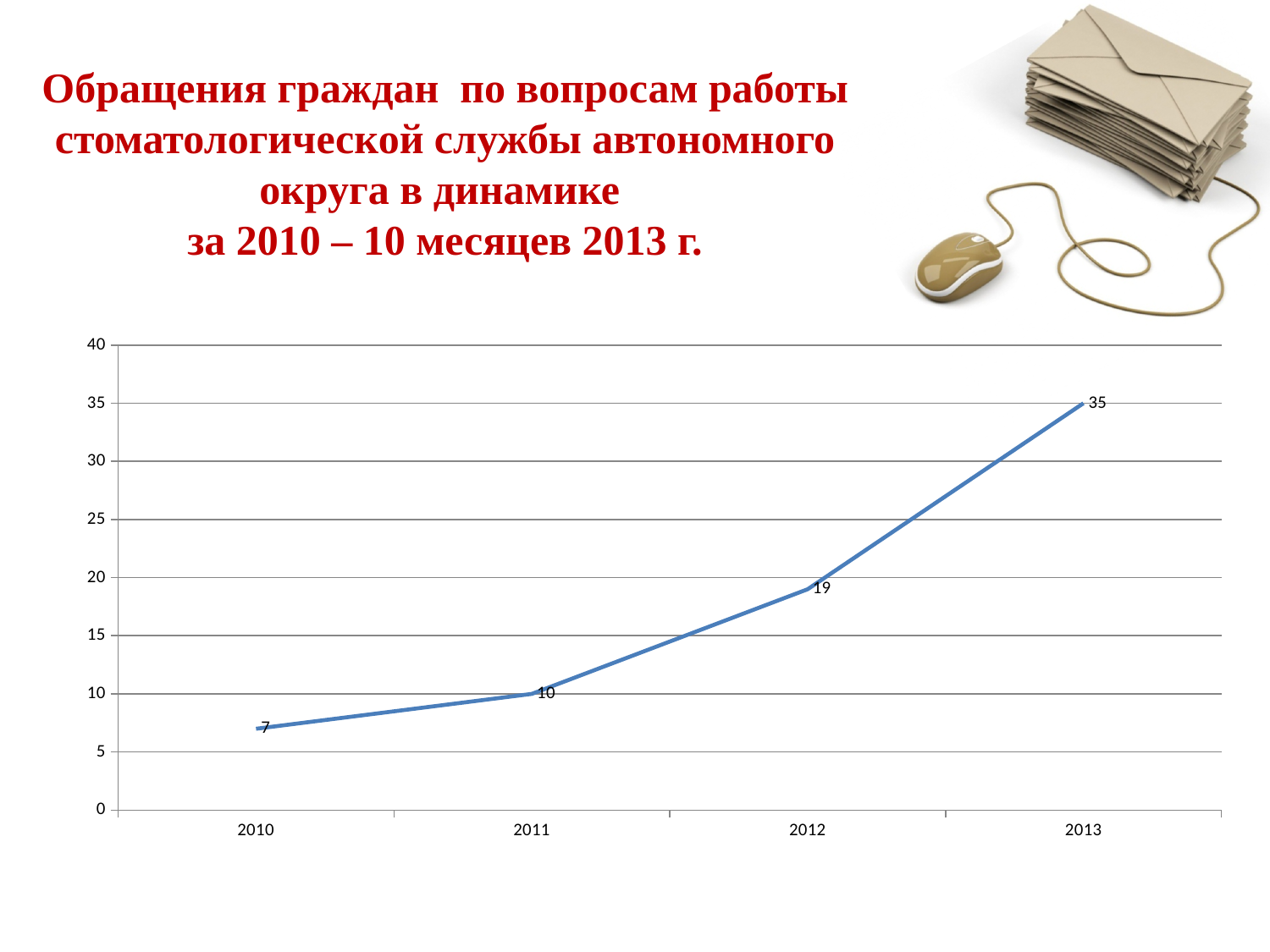
Which year has the highest value? 2013 What is the difference between the values for 2013 and 2012? 16 What is the value for 2010? 7 Which is larger, the value for 2012 or the value for 2011? 2012 What is the difference between the values for 2011 and 2010? 3 What is the value for 2012? 19 Do the values rise or fall from 2010 to 2013? rise What is the value for 2011? 10 What is the value for 2013? 35 Which year has the lowest value? 2010 How many years are plotted on the chart? 4 What kind of chart is shown on the slide? line chart